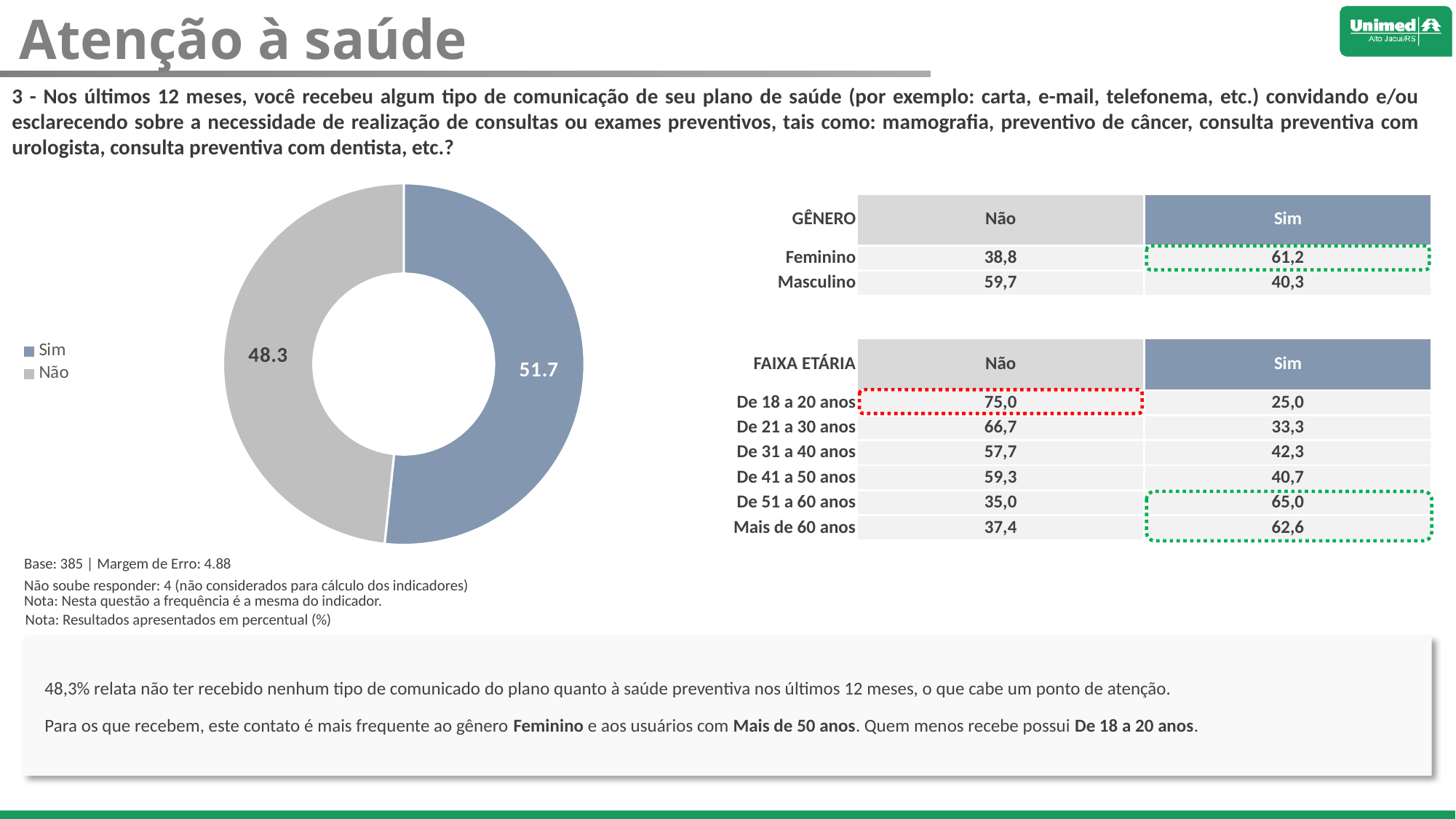
Which is larger in the donut chart, "Sim" or "Não"? Sim What kind of chart is shown on the left of the slide? Pie (donut) chart What is the value shown for the "Não" slice of the donut chart? 48.3 What is the difference between the "Sim" and "Não" values in the donut chart? 3.4 How many entries does the legend of the donut chart list? 2 How many slices does the donut chart have? 2 Which slice of the donut chart is the largest? Sim Which slice of the donut chart is the smallest? Não What is the value shown for the "Sim" slice of the donut chart? 51.7 What colour is the "Não" slice in the donut chart? Grey What colour is the "Sim" slice in the donut chart? Blue